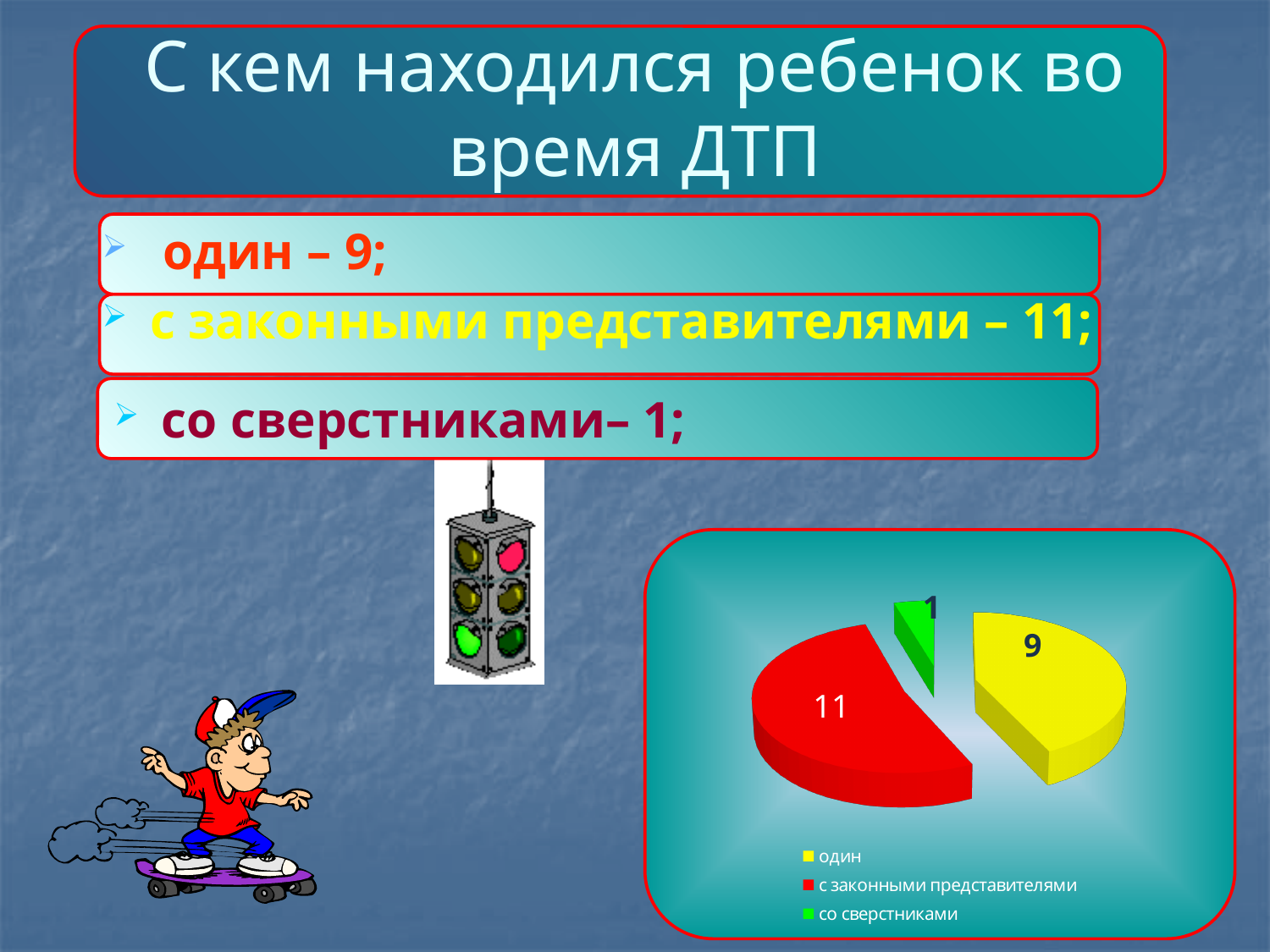
What is the value for the slice "с законными представителями" in the pie chart? 11 What is the total of all the values shown in the pie chart? 21 How many slices does the pie chart have? 3 What is the value for the slice "со сверстниками" in the pie chart? 1 Which category has the smallest slice in the pie chart? со сверстниками Which category has the largest slice in the pie chart? с законными представителями What is the difference between the values for "с законными представителями" and "один"? 2 What is the difference between the values for "один" and "со сверстниками"? 8 What kind of chart is shown on the slide? pie chart What colour is the slice for "со сверстниками" in the pie chart? green What is the value for the slice "один" in the pie chart? 9 Which is larger: the value for "один" or the value for "с законными представителями"? с законными представителями